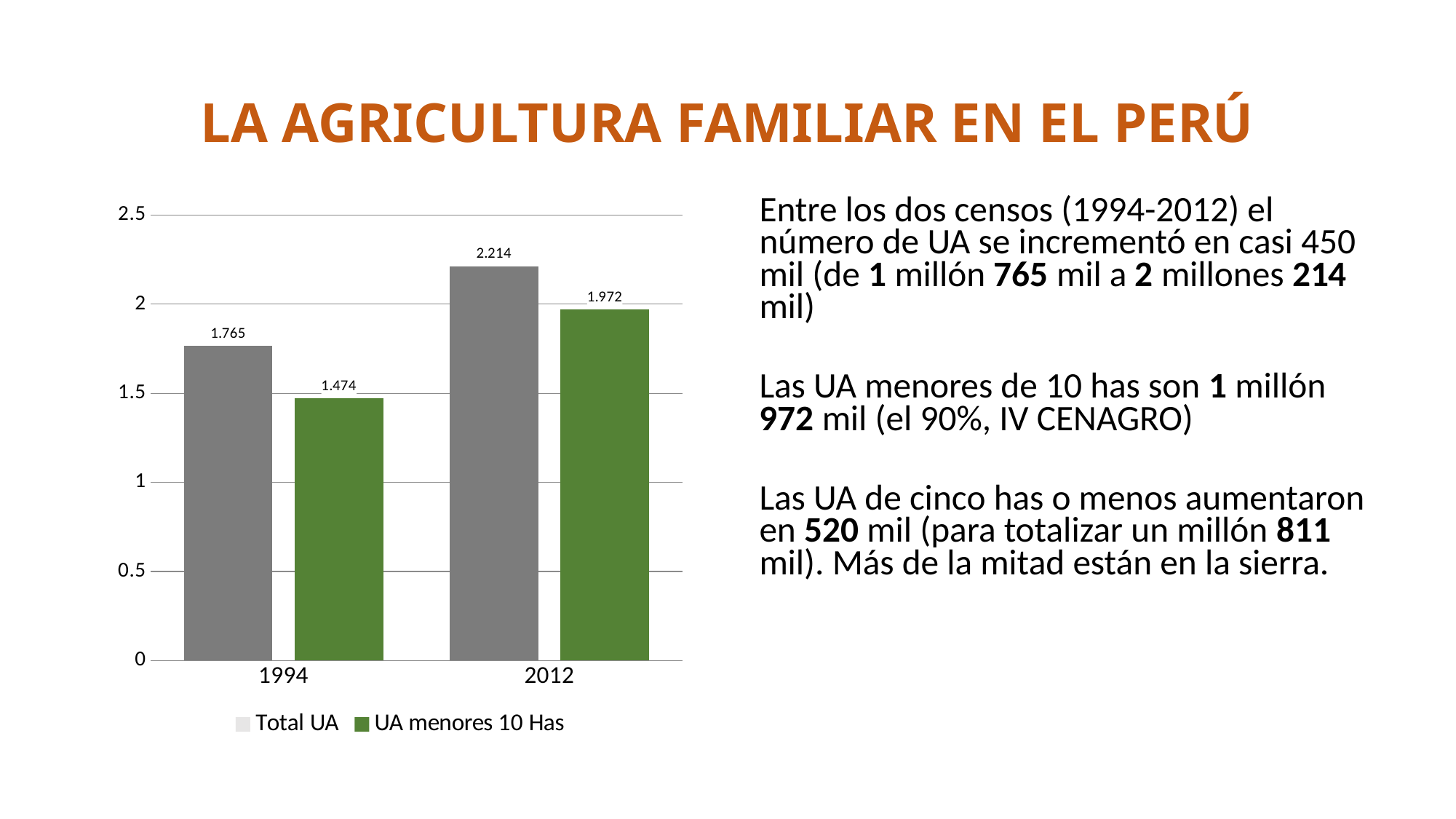
Which bar has the lowest value in the chart? UA menores 10 Has in 1994 What kind of chart is shown on the slide? Bar chart How many series does the legend list? 2 How many categories are shown on the x axis? 2 What is the value of UA menores 10 Has for 2012? 1.972 What is the difference between Total UA in 2012 and Total UA in 1994? 0.449 Does the Total UA series rise or fall from 1994 to 2012? Rise What is the value of Total UA for 1994? 1.765 Which is larger: Total UA in 1994 or UA menores 10 Has in 2012? UA menores 10 Has in 2012 Which year has the highest Total UA value? 2012 What is the value of Total UA for 2012? 2.214 What is the value of UA menores 10 Has for 1994? 1.474